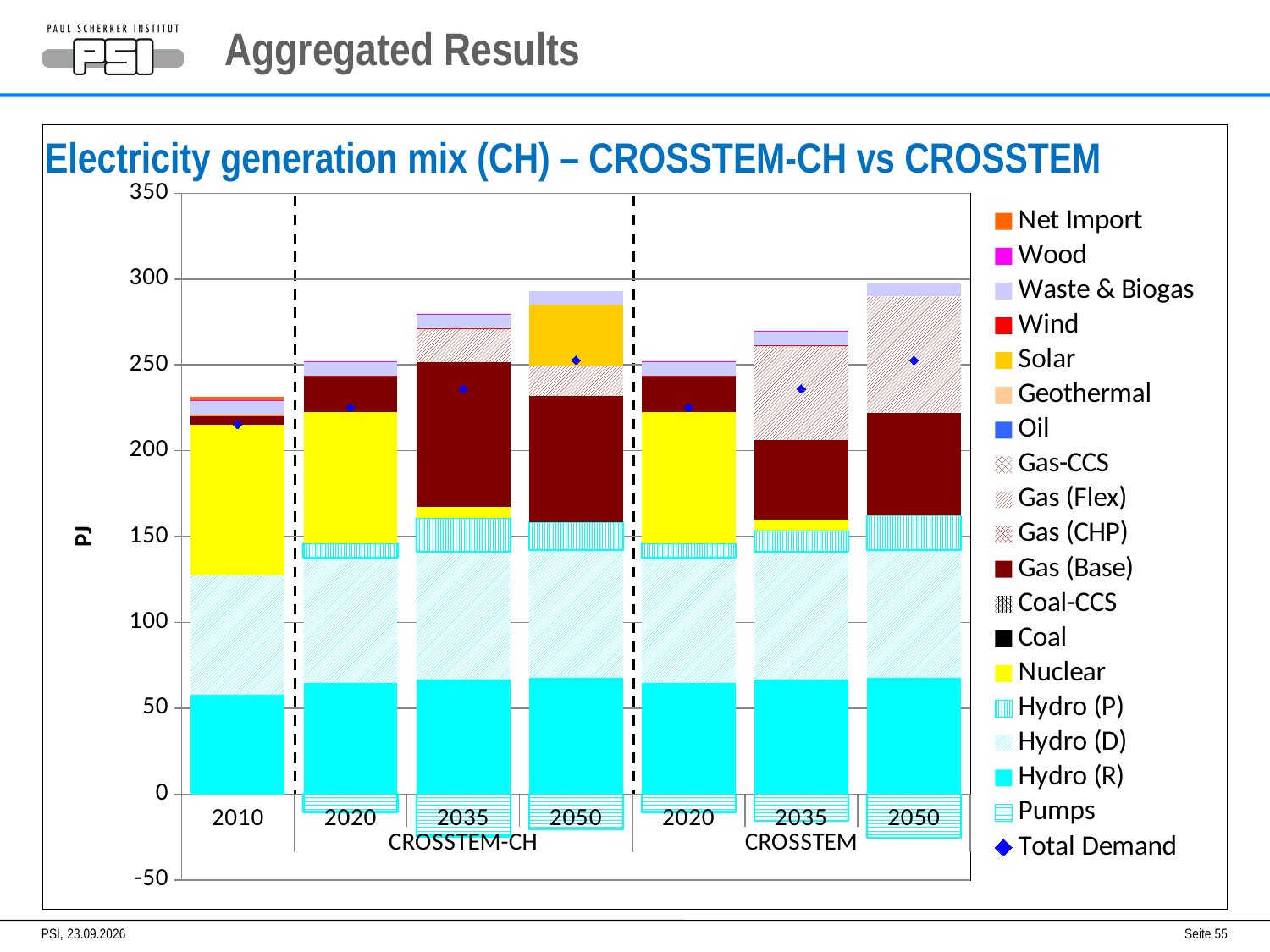
What unit is shown on the y-axis label of the chart? PJ Within the CROSSTEM-CH group, do the total bar heights rise or fall from 2020 to 2050? rise Which is larger, the total of the 2010 bar or the total of the 2050 bar in the CROSSTEM-CH group? 2050 (CROSSTEM-CH) Is the total height of the 2010 bar greater or less than 200? greater What is the title of the chart? Electricity generation mix (CH) – CROSSTEM-CH vs CROSSTEM How many entries does the chart legend list? 19 Which bar has the lowest total generation? 2010 Is the total height of the 2035 bar in the CROSSTEM group greater or less than 250? greater Is the Hydro (R) segment of the 2010 bar greater or less than 100? less How many bars (year categories) are plotted in the chart? 7 What kind of chart is shown on the slide? Stacked bar chart